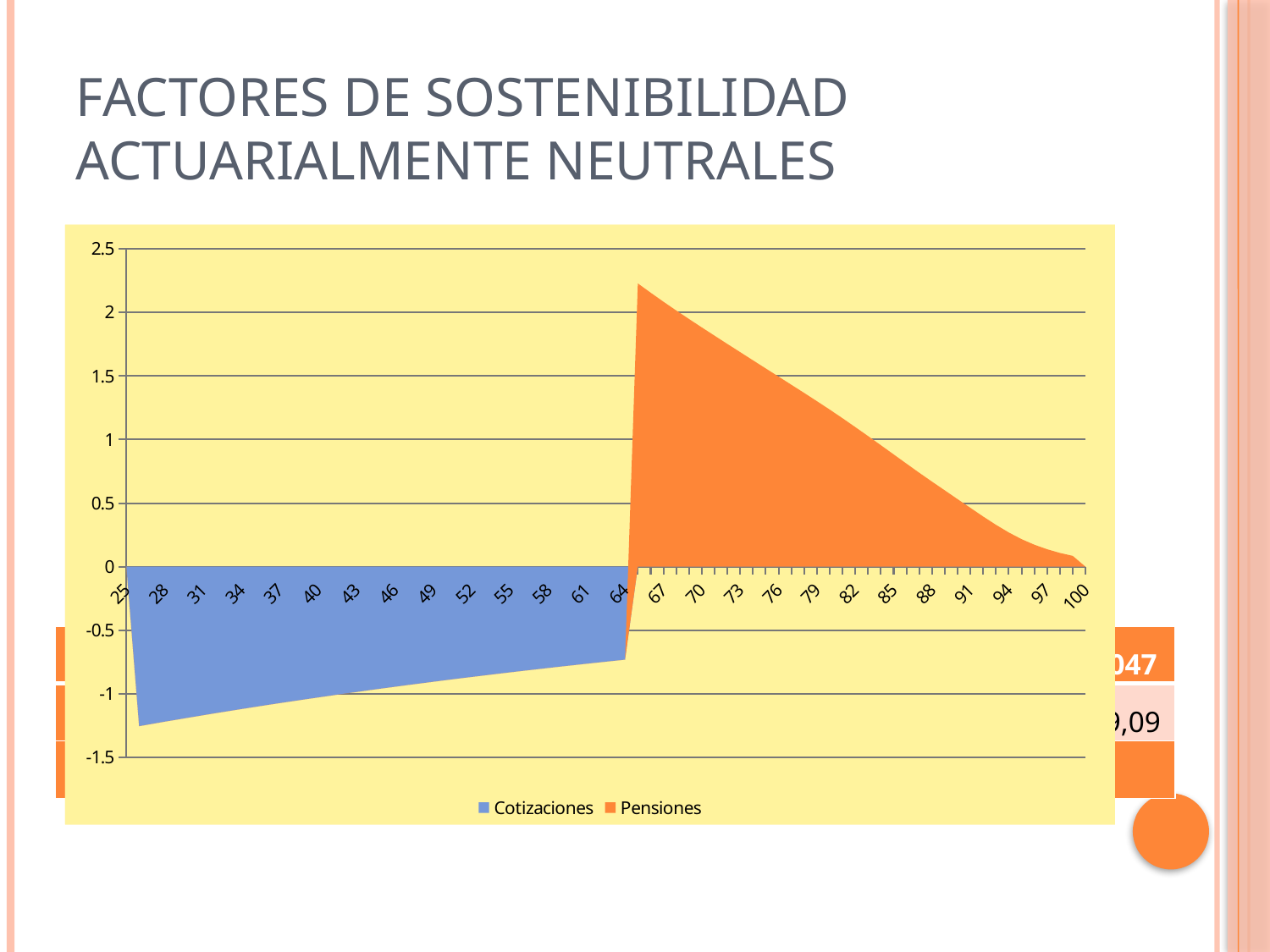
Which series reaches the highest value on the chart? Pensiones What are the two series named in the legend? Cotizaciones and Pensiones Do the Pensiones values rise or fall from 67 to 100 along the x axis? Fall Is the value for Cotizaciones at 64 greater or less than -1? greater How many series does the legend list? 2 Is the value for Pensiones at 85 greater or less than 1? less Which series has values below zero? Cotizaciones What kind of chart is shown on the slide? Area chart Is the value for Pensiones at 67 greater or less than 1.5? greater How many labels are shown on the x axis? 26 Which colour represents the Pensiones series? Orange